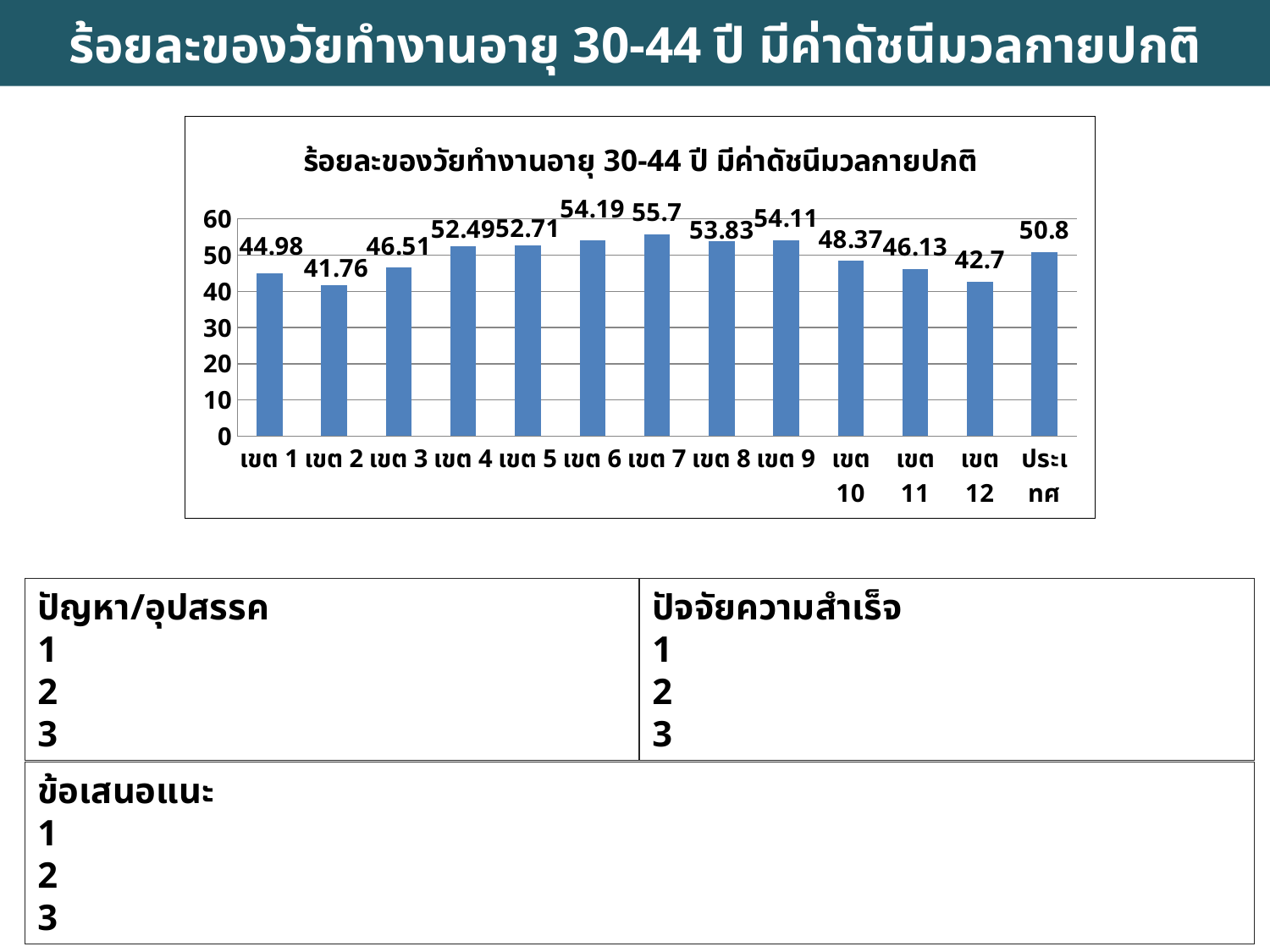
Which category has the highest value? เขต 7 Which category has the lowest value? เขต 2 Do the values rise or fall from เขต 9 to เขต 12? fall What is the value for ประเทศ? 50.8 What is the title of the chart? ร้อยละของวัยทำงานอายุ 30-44 ปี มีค่าดัชนีมวลกายปกติ Which is larger, the value for เขต 4 or the value for เขต 10? เขต 4 What is the difference between the values for เขต 7 and เขต 2? 13.94 What kind of chart is shown on the slide? bar chart How many categories are shown on the x axis? 13 What is the value for เขต 12? 42.7 Is the value for เขต 6 greater or less than 50? greater What is the value for เขต 7? 55.7